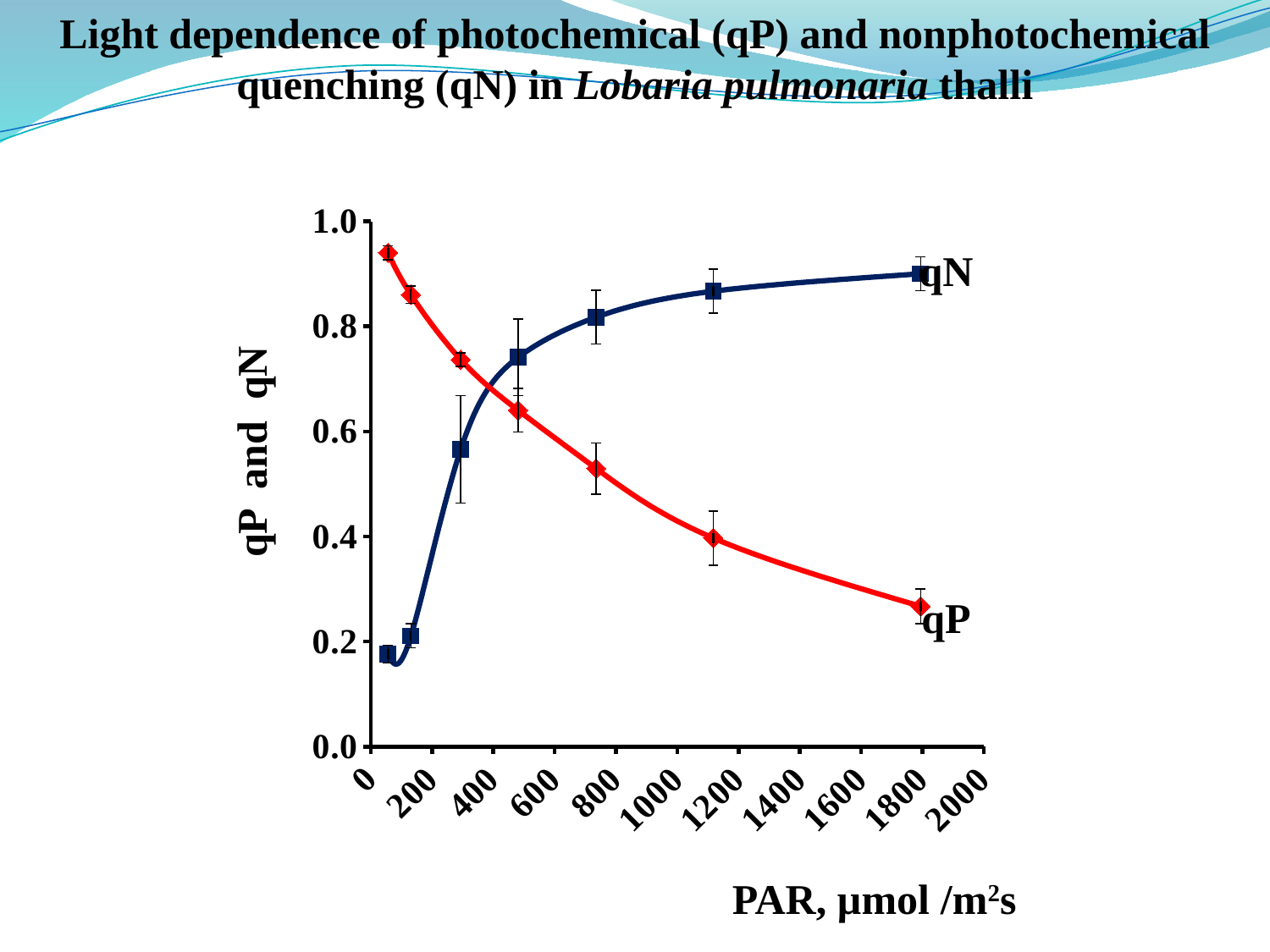
At PAR 1800, which series has the larger value, qN or qP? qN At the lowest PAR point, which series has the larger value, qN or qP? qP Is the qP value at the lowest PAR point greater or less than 0.8? greater What colour is the qP line? red How many series are plotted on the chart? 2 Does the qP series rise or fall as PAR increases along the x axis? falls Does the qN series rise or fall as PAR increases along the x axis? rises Is the qP value at PAR 1800 greater or less than 0.4? less What kind of chart is shown on the slide? line chart What is the label of the x axis? PAR, μmol /m²s Is the qN value at PAR 1800 greater or less than 0.8? greater